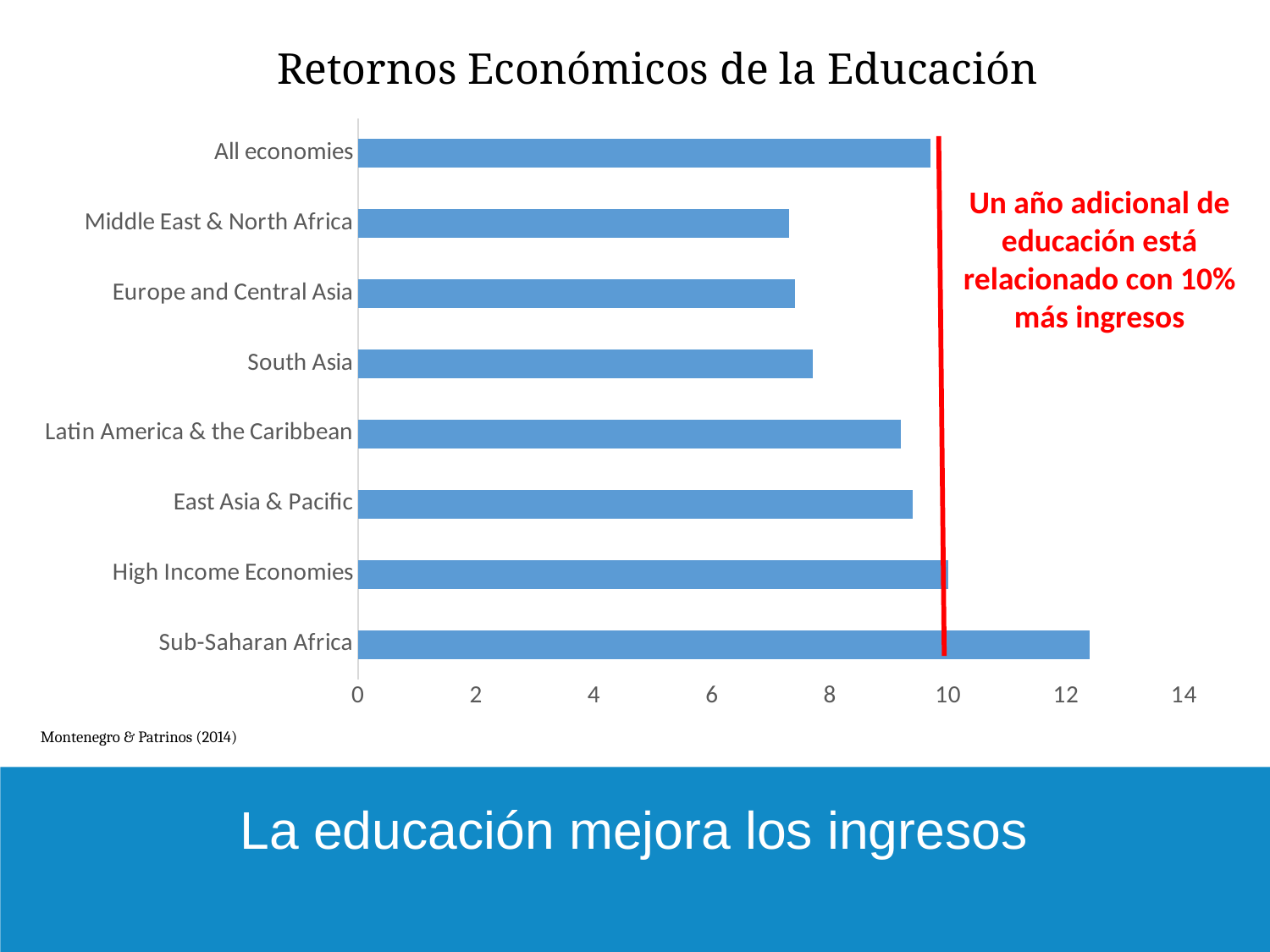
Is the value for Sub-Saharan Africa greater or less than 10? greater Is the value for Latin America & the Caribbean greater or less than 10? less Is the value for East Asia & Pacific greater or less than 8? greater Which is larger, the value for Latin America & the Caribbean or the value for Middle East & North Africa? Latin America & the Caribbean What source is cited below the chart? Montenegro & Patrinos (2014) Which category has the highest value in the chart? Sub-Saharan Africa How many categories (regions/economy groups) are plotted in the chart? 8 What is the title of the chart? Retornos Económicos de la Educación What kind of chart is shown on the slide? bar chart Which is larger, the value for Sub-Saharan Africa or the value for South Asia? Sub-Saharan Africa